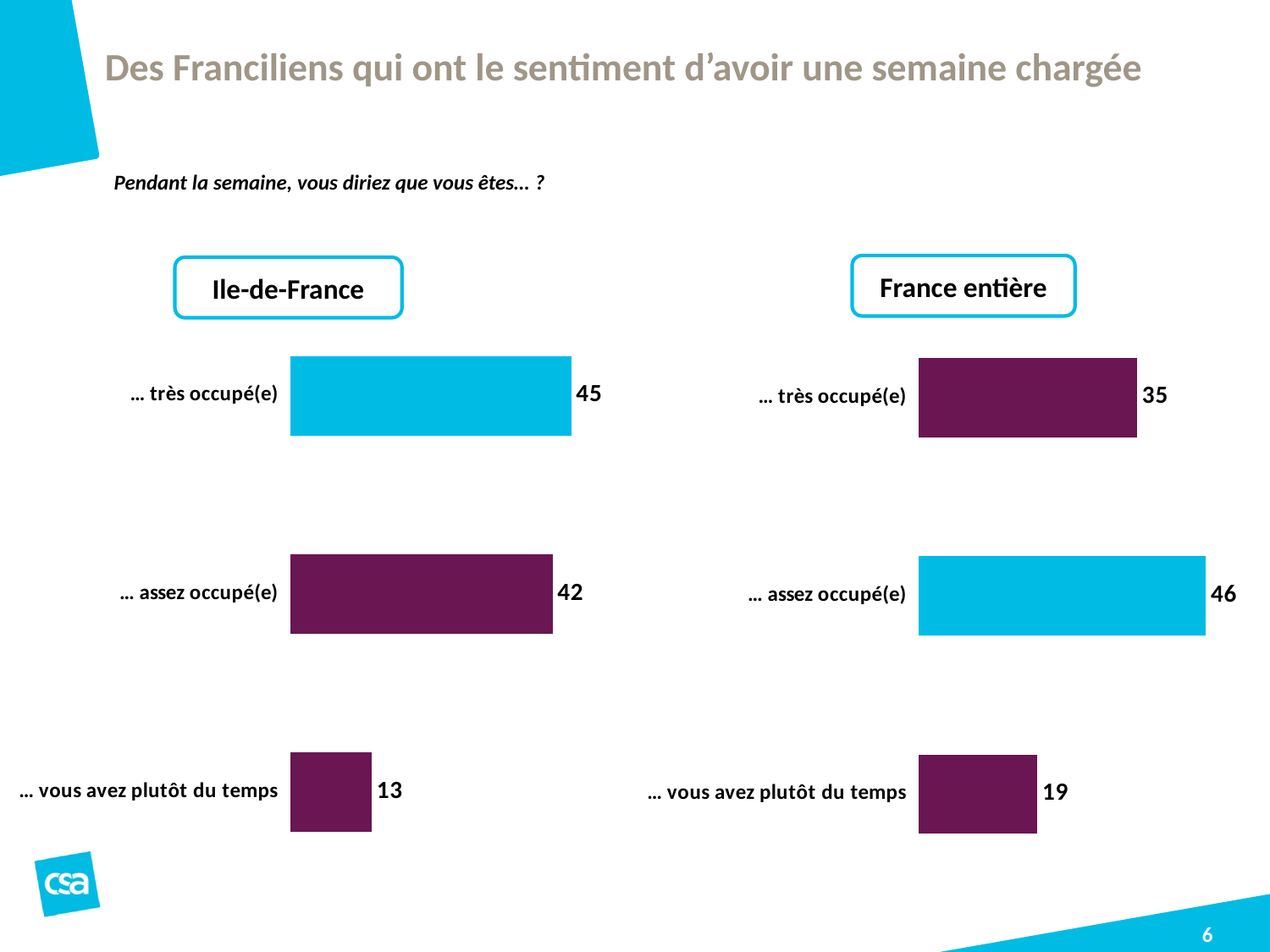
In the Ile-de-France chart, which category has the lowest value? … vous avez plutôt du temps What is the difference between "… vous avez plutôt du temps" in the France entière chart and in the Ile-de-France chart? 6 In the France entière chart, what is the value for "… vous avez plutôt du temps"? 19 In the Ile-de-France chart, which bar is coloured light blue? … très occupé(e) Which is larger: "… très occupé(e)" in the Ile-de-France chart or "… très occupé(e)" in the France entière chart? Ile-de-France In the France entière chart, which category has the highest value? … assez occupé(e) In the Ile-de-France chart, what is the value for "… très occupé(e)"? 45 In the Ile-de-France chart, what is the difference between "… très occupé(e)" and "… assez occupé(e)"? 3 In the France entière chart, what is the difference between "… assez occupé(e)" and "… vous avez plutôt du temps"? 27 What kind of chart is the France entière chart? Bar chart How many categories does the Ile-de-France chart show? 3 In the France entière chart, what is the value for "… assez occupé(e)"? 46